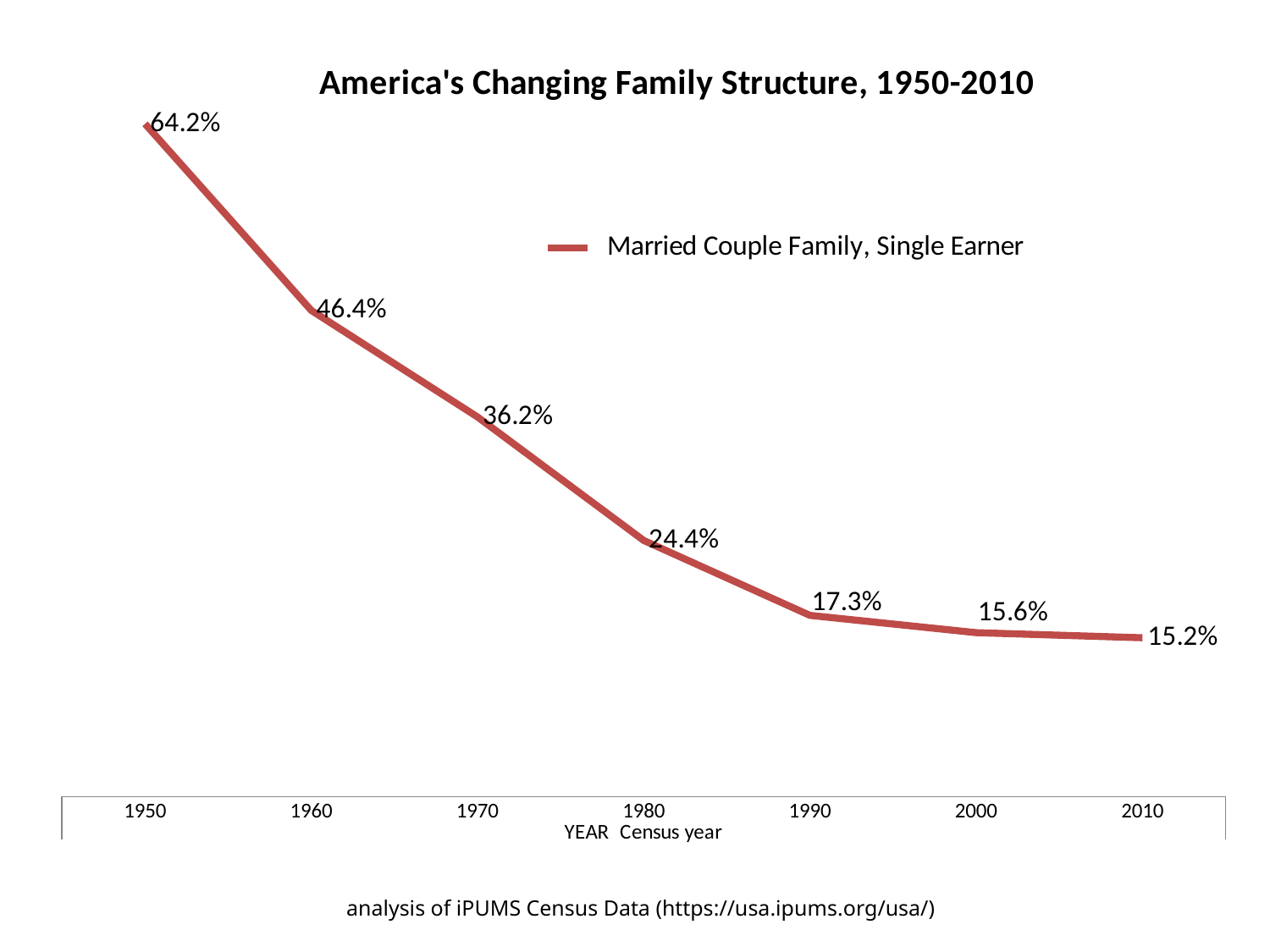
What kind of chart is this? line chart Do the values rise or fall from 1950 to 2010? fall Which is larger, the value for 1970 or the value for 1980? 1970 What is the difference between the values for 1950 and 1960? 17.8% Which year has the lowest value? 2010 What is the value for 1990? 17.3% What is the difference between the values for 2000 and 2010? 0.4% What is the value for 1950? 64.2% What is the value for 1980? 24.4% What is the value for 2010? 15.2% How many years are plotted on the x axis? 7 Which year has the highest value? 1950